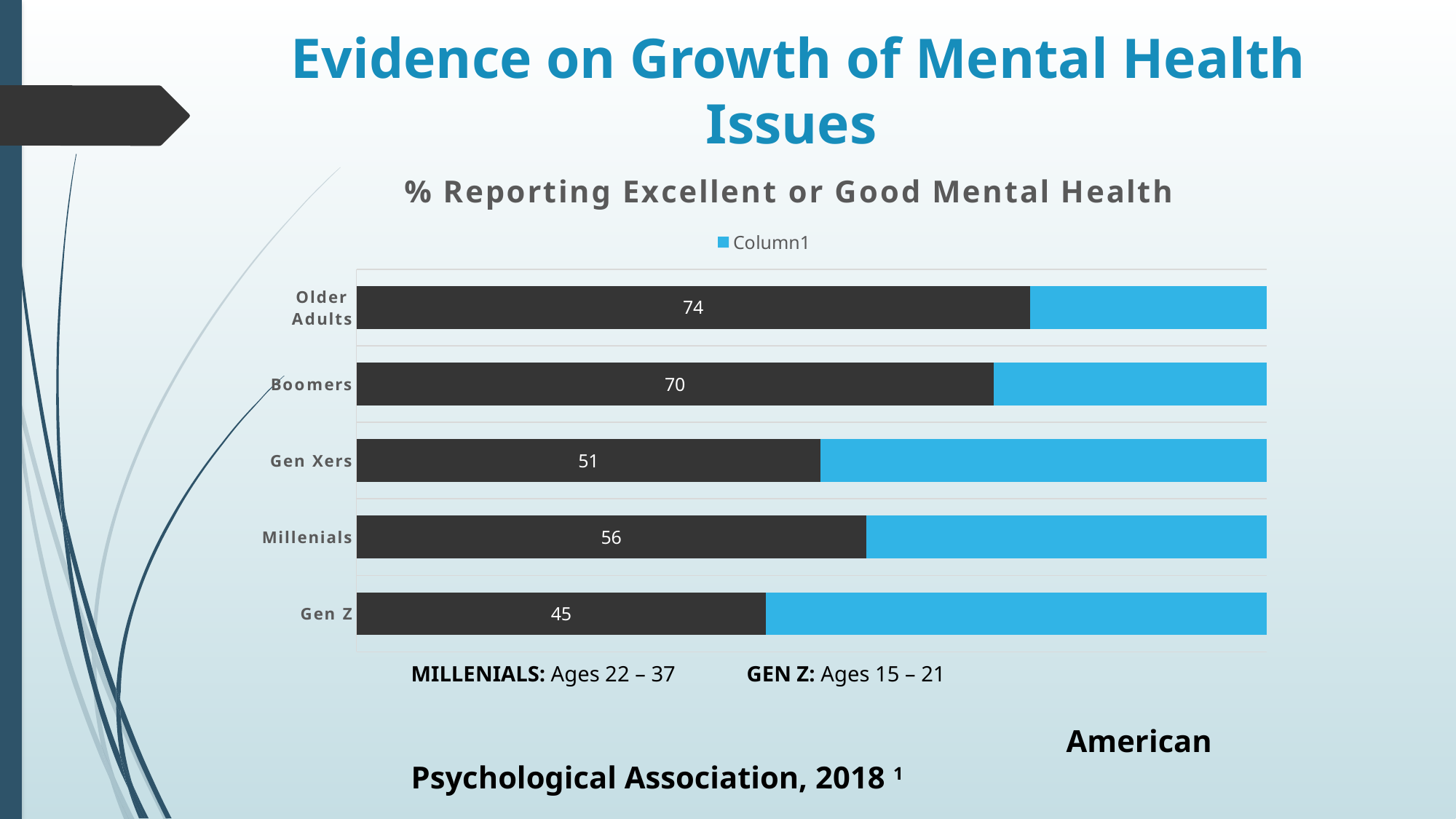
What is the title of the chart? % Reporting Excellent or Good Mental Health What value is shown for Older Adults in the dark series? 74 Which has a larger labelled value, Gen Xers or Millenials? Millenials What kind of chart is shown on the slide? Bar chart What value is shown for Boomers in the dark series? 70 What is the difference between the labelled values for Older Adults and Gen Z? 29 How many categories are shown on the chart? 5 What value is shown for Millenials in the dark series? 56 Which category has the highest labelled value? Older Adults Which category has the lowest labelled value? Gen Z What value is shown for Gen Z in the dark series? 45 What is the difference between the labelled values for Millenials and Gen Xers? 5